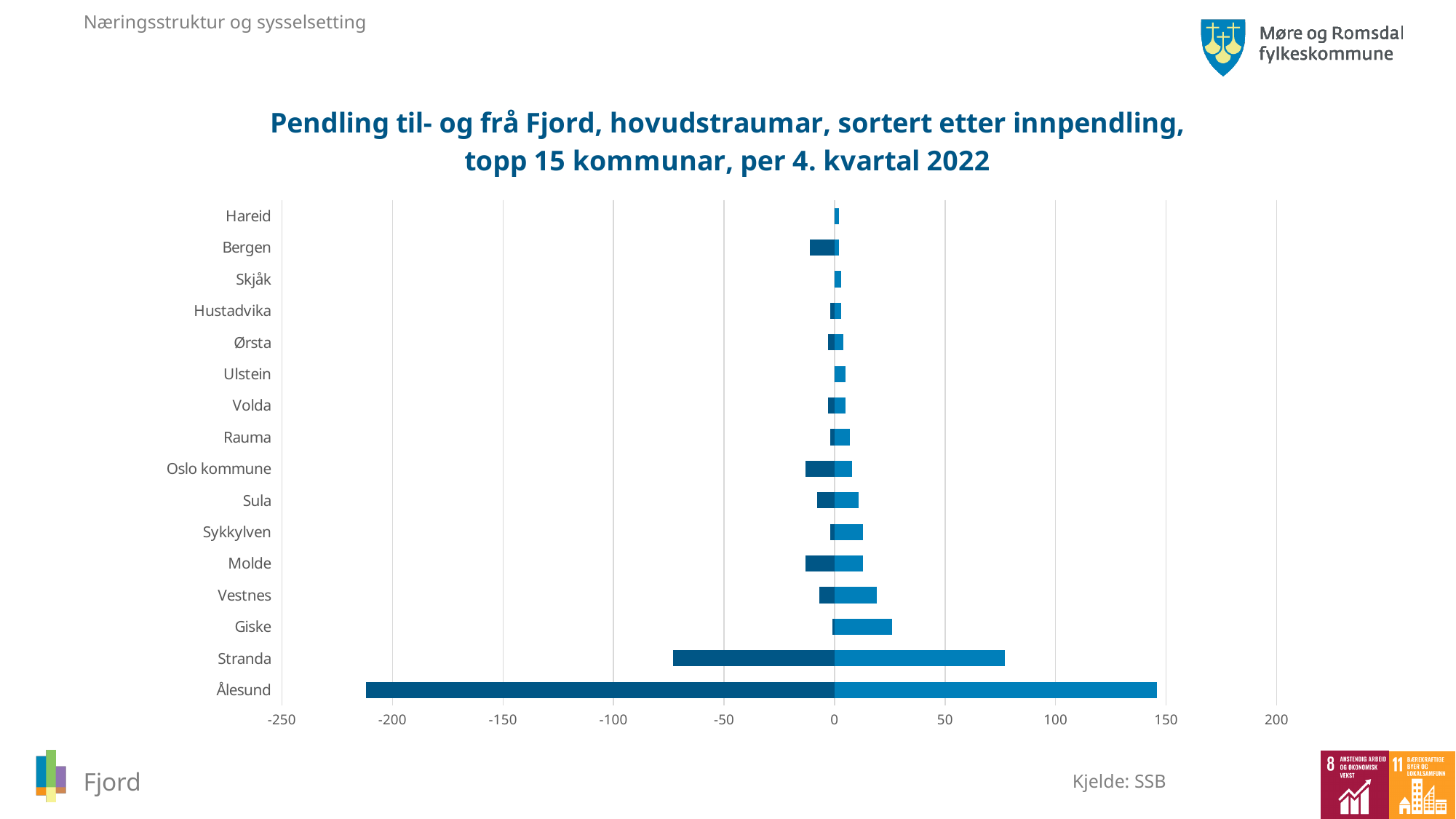
What source is cited for the chart data? SSB Is the positive (light blue) value for Giske greater or less than 50? less Is the positive (light blue) value for Ålesund greater or less than 100? greater What kind of chart is shown on the slide? bar chart What is the title of the chart? Pendling til- og frå Fjord, hovudstraumar, sortert etter innpendling, topp 15 kommunar, per 4. kvartal 2022 Is the negative (dark blue) value for Stranda greater or less than -50? less How many municipalities (categories) are listed on the vertical axis of the chart? 16 Which municipality has the longest negative (dark blue) bar in the chart? Ålesund Which municipality has the longest positive (light blue) bar in the chart? Ålesund Which has the longer positive (light blue) bar, Stranda or Giske? Stranda